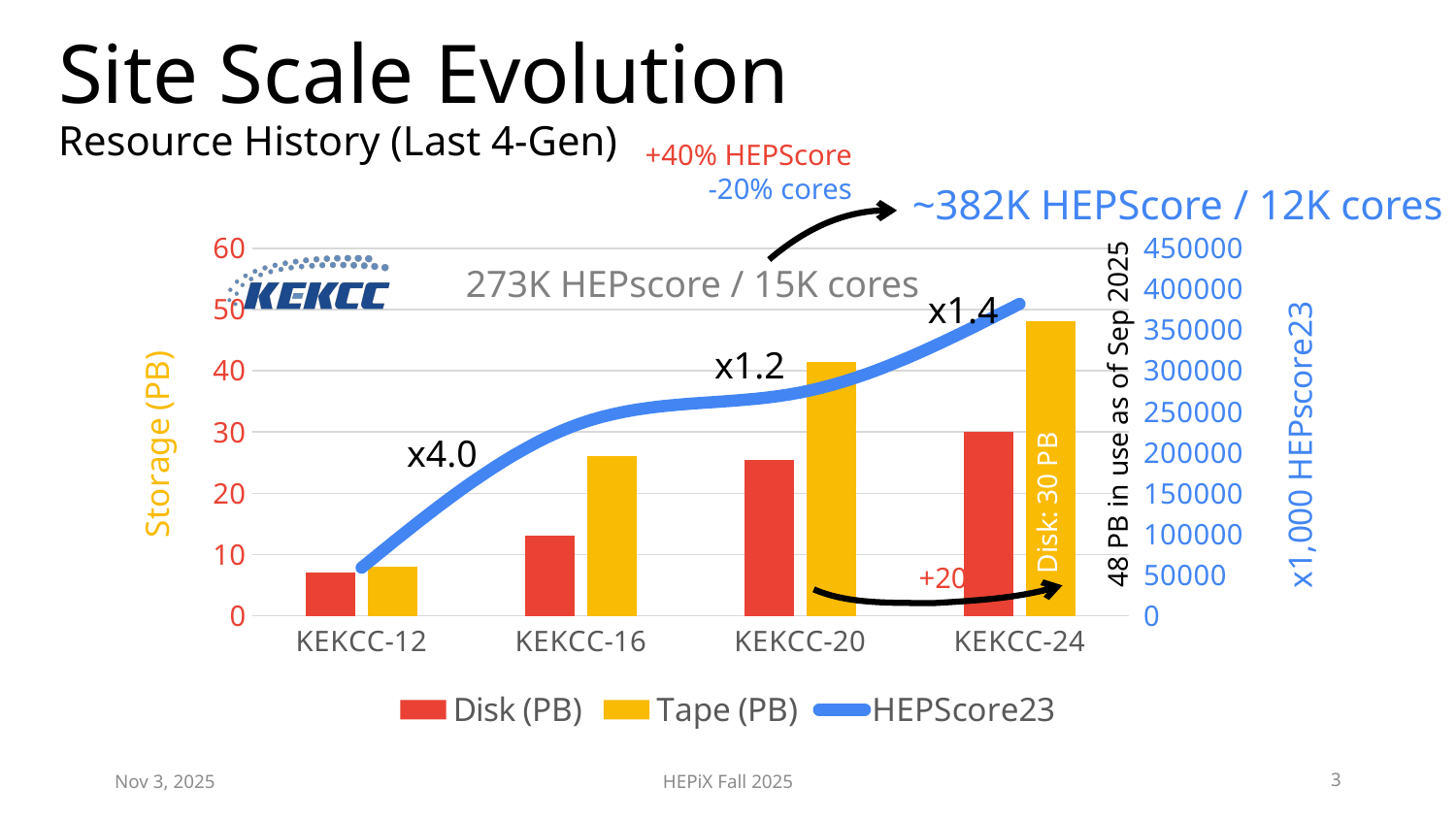
How many generations (categories) are shown on the x axis of the chart? 4 Which generation has the lowest Disk (PB) value? KEKCC-12 What is the title of the left vertical axis? Storage (PB) Does the HEPScore23 line rise or fall from KEKCC-12 to KEKCC-24? Rises For KEKCC-20, which is larger: Disk (PB) or Tape (PB)? Tape (PB) Is the Tape (PB) value for KEKCC-24 greater or less than 40? greater How many series does the chart legend list? 3 Is the Disk (PB) value for KEKCC-12 greater or less than 10? less Is the Disk (PB) value for KEKCC-16 greater or less than 20? less What is the Disk value for KEKCC-24, as labelled on the bar? 30 PB Which generation has the highest Tape (PB) value? KEKCC-24 What kind of chart is used to show Disk (PB) and Tape (PB)? Bar chart